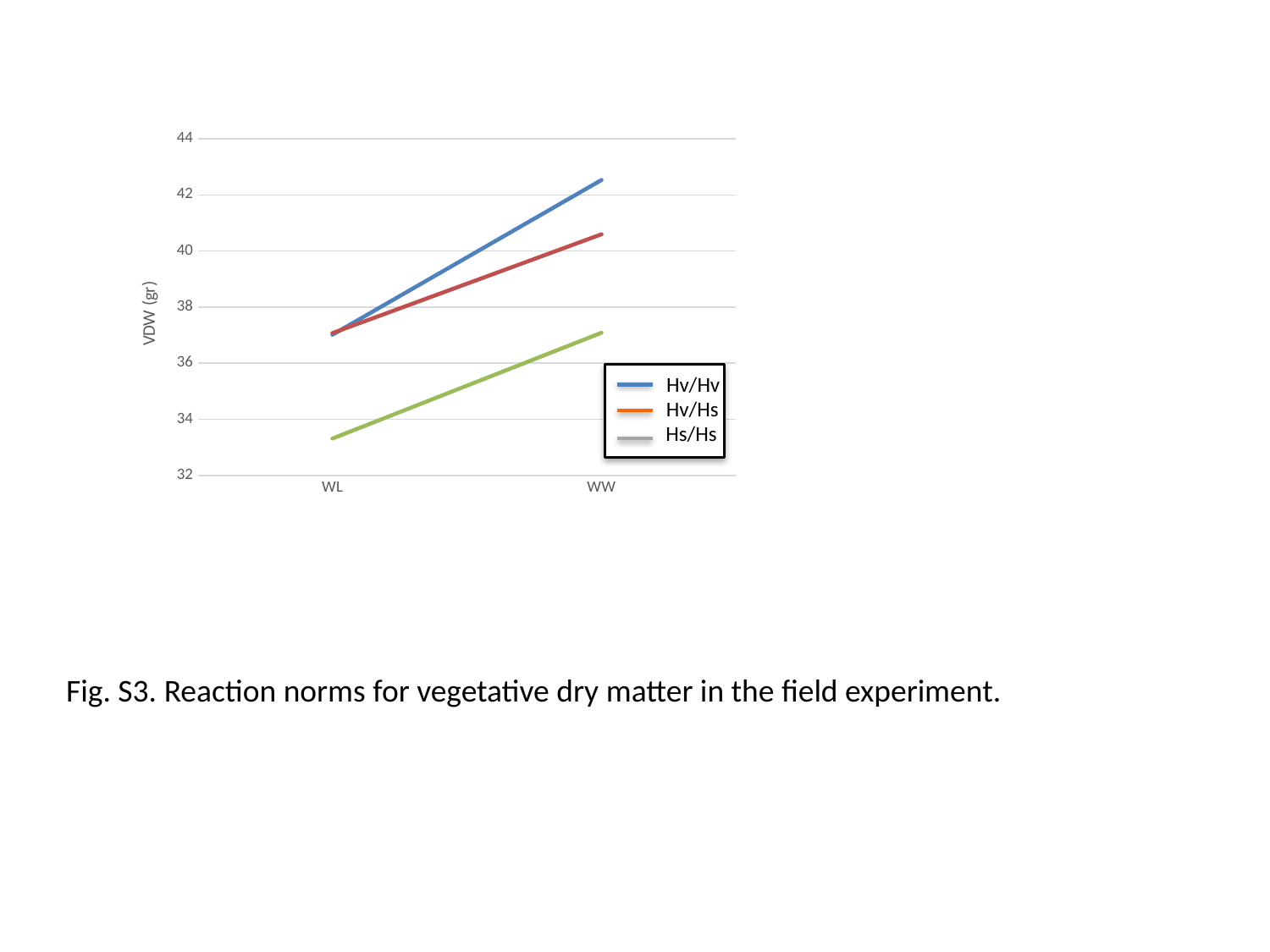
How many categories are shown on the x axis? 2 What kind of chart is shown on the slide? line chart Is the value for Hv/Hv at WW greater or less than 42? greater Is the value for Hs/Hs at WL greater or less than 34? less How many series does the legend list? 3 Which series has the highest value at WW? Hv/Hv At WW, which is larger: the value for Hv/Hs or the value for Hs/Hs? Hv/Hs What is the label of the y axis? VDW (gr) Which series has the lowest value at WL? Hs/Hs Do the values for Hs/Hs rise or fall from WL to WW? rise Is the value for Hv/Hs at WW greater or less than 40? greater Do the values for Hv/Hv rise or fall from WL to WW? rise